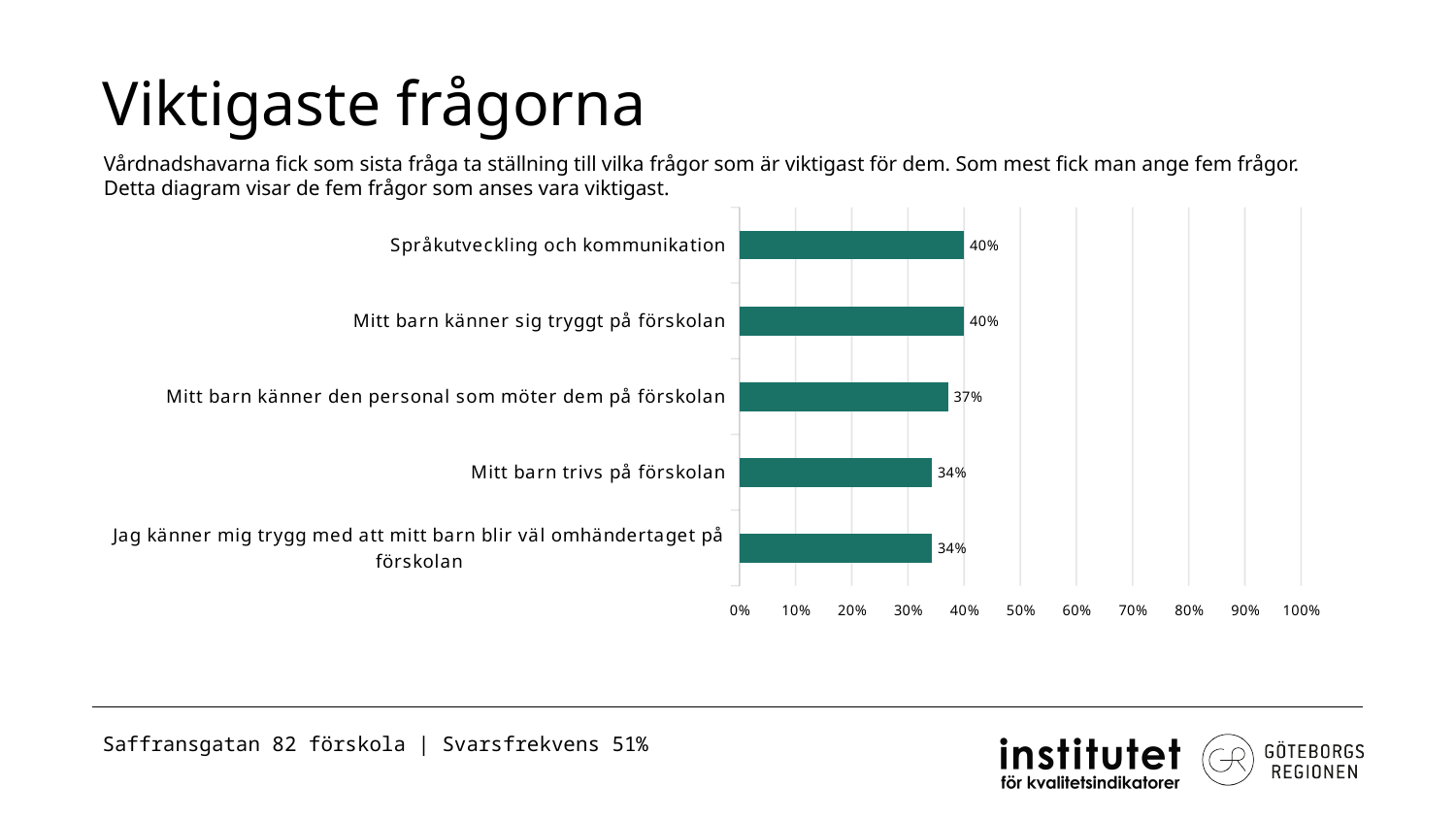
What is the value for "Mitt barn trivs på förskolan"? 34% What is the value for "Språkutveckling och kommunikation"? 40% What kind of chart is shown on the slide? bar chart What is the value for "Mitt barn känner den personal som möter dem på förskolan"? 37% Is the value for "Mitt barn trivs på förskolan" greater or less than 50%? less How many categories are shown in the chart? 5 Which has a larger value: "Språkutveckling och kommunikation" or "Mitt barn trivs på förskolan"? Språkutveckling och kommunikation What is the value for "Jag känner mig trygg med att mitt barn blir väl omhändertaget på förskolan"? 34% What is the highest value shown in the chart? 40% What is the difference between the value for "Mitt barn känner sig tryggt på förskolan" and the value for "Mitt barn känner den personal som möter dem på förskolan"? 3% What is the difference between the value for "Språkutveckling och kommunikation" and the value for "Mitt barn trivs på förskolan"? 6% What is the lowest value shown in the chart? 34%